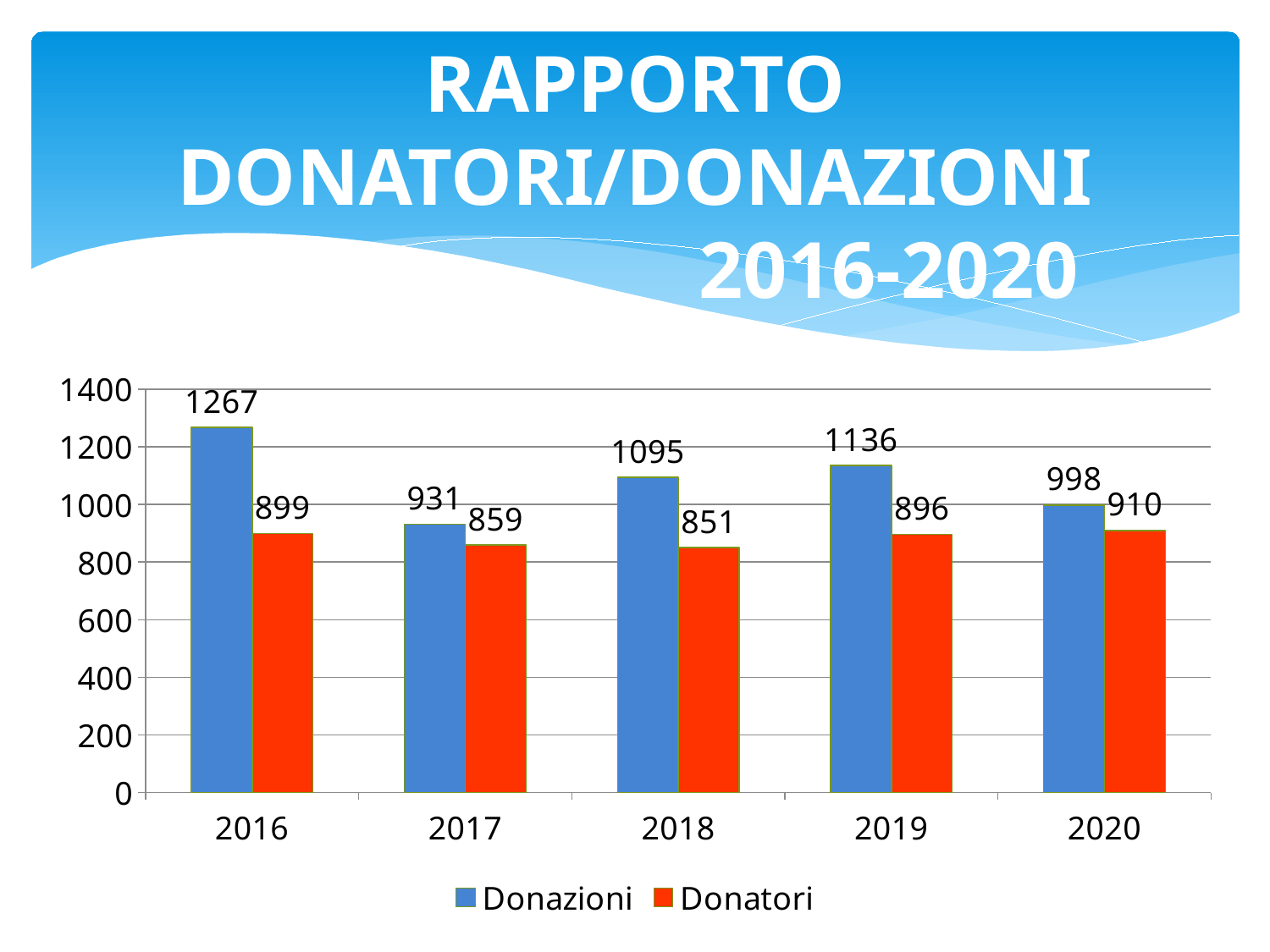
What is the value of Donatori for 2018? 851 What kind of chart is shown on the slide? Bar chart Which colour represents Donatori in the chart? Red How many series does the legend list? 2 What is the difference between Donazioni and Donatori in 2019? 240 How many years are shown on the x axis? 5 What is the value of Donazioni for 2020? 998 Which year has the lowest value for Donazioni? 2017 Which is larger in 2017, Donazioni or Donatori? Donazioni Which year has the lowest value for Donatori? 2018 Which year has the highest value for Donazioni? 2016 What is the value of Donazioni for 2016? 1267